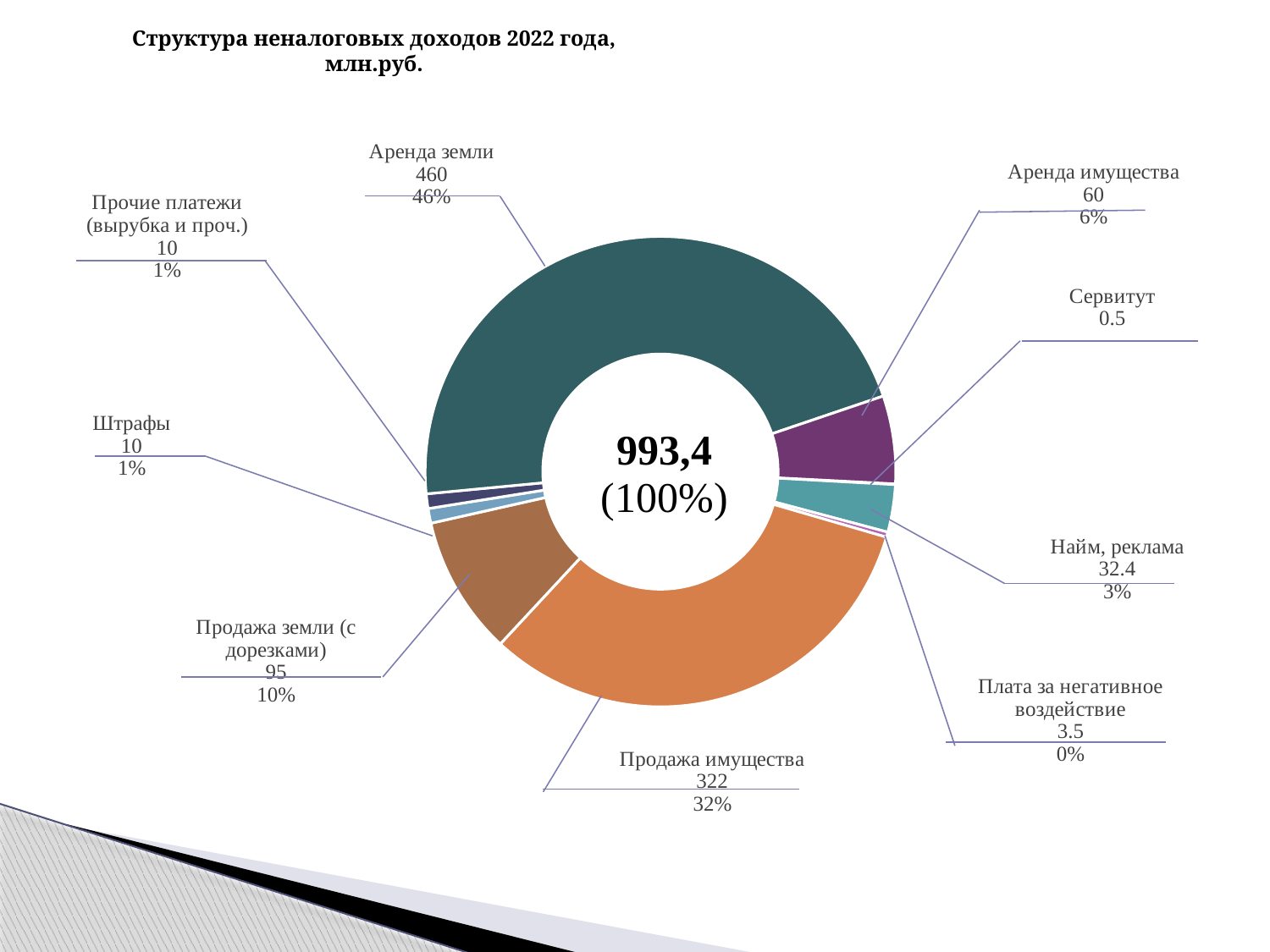
Which is larger, Аренда имущества or Продажа земли (с дорезками)? Продажа земли (с дорезками) What total value is shown in the centre of the chart? 993,4 What is the value for Аренда земли? 460 What is the value for Продажа имущества? 322 Which category has the largest value? Аренда земли What is the difference between Аренда земли and Продажа имущества? 138 What kind of chart is shown on the slide? Pie (doughnut) chart What is the value for Найм, реклама? 32.4 What is the value for Сервитут? 0.5 How many categories does the chart show? 9 What share of the total does Продажа имущества represent? 32% Which category has the smallest value? Сервитут